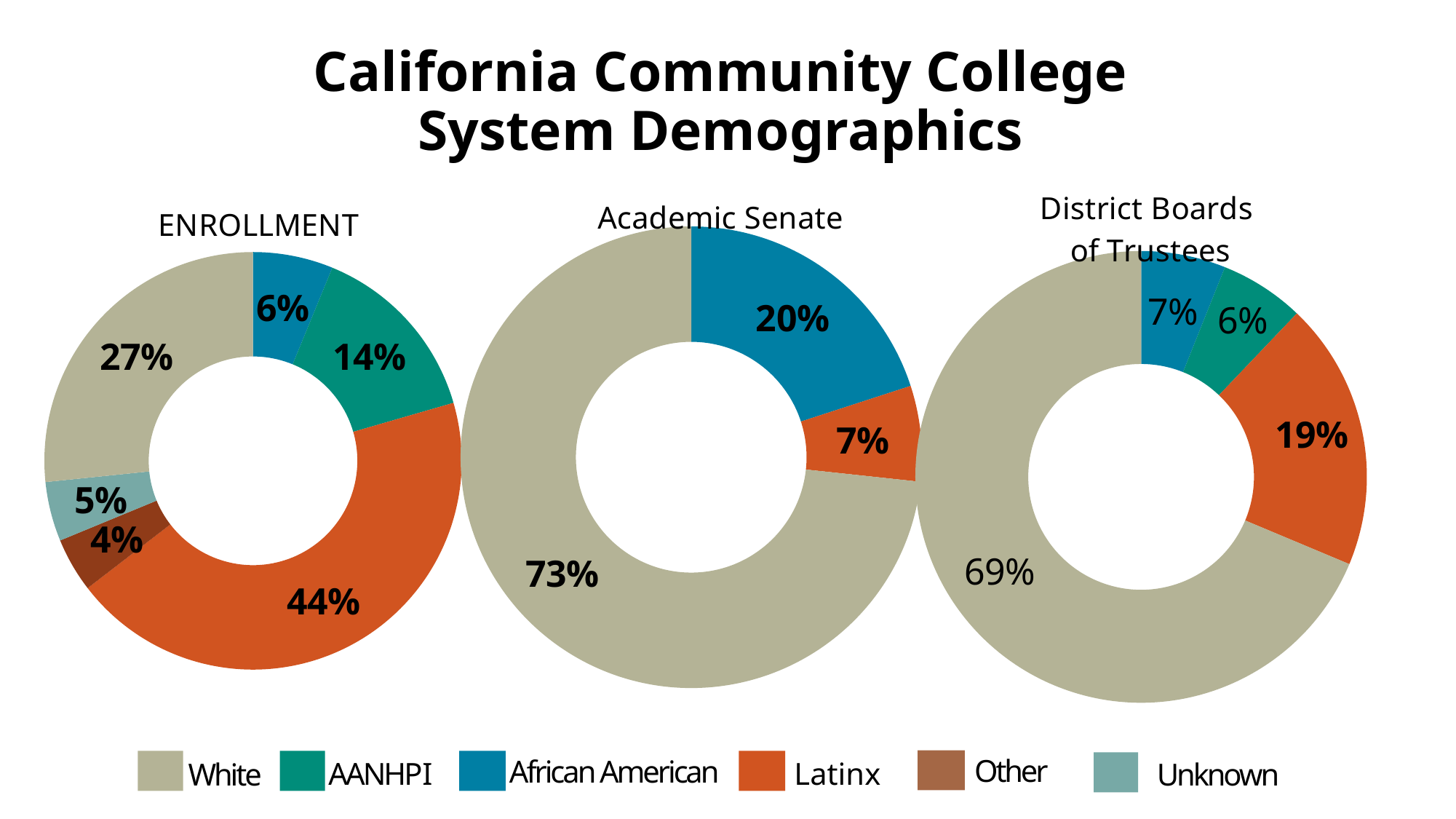
What kind of chart is used for the three demographic breakdowns? Donut (pie) chart In the Academic Senate chart, what share is White? 73% In the Academic Senate chart, which group has the largest share? White How many entries does the legend list? 6 In the ENROLLMENT chart, what share is AANHPI? 14% How many slices does the Academic Senate chart have? 3 How many slices does the ENROLLMENT chart have? 6 In the District Boards of Trustees chart, what share is Latinx? 19% In the ENROLLMENT chart, what share is Latinx? 44% In the ENROLLMENT chart, which group has the smallest share? Other In the ENROLLMENT chart, what is the difference between the Latinx share and the White share? 17% Which is larger: the African American share in the Academic Senate chart or in the District Boards of Trustees chart? Academic Senate